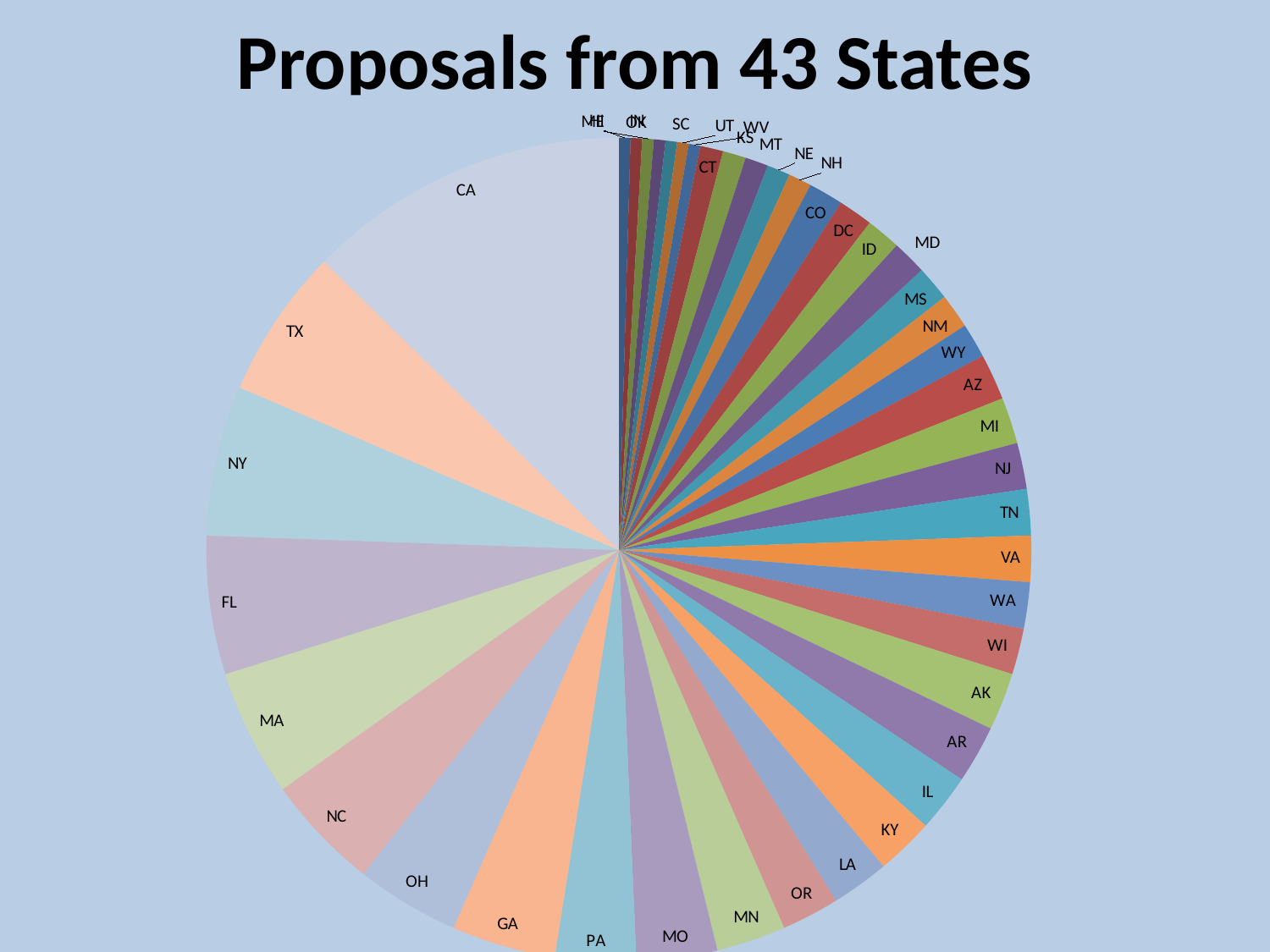
Which slice is larger, CA or NY? CA Does the chart display a legend? No How many states are represented in the pie chart, according to the title? 43 Which slice is larger, OH or AK? OH Which slice is larger, CA or TX? CA What is the title of the chart? Proposals from 43 States Which state has the largest slice of the pie? CA What kind of chart is shown on the slide? pie chart